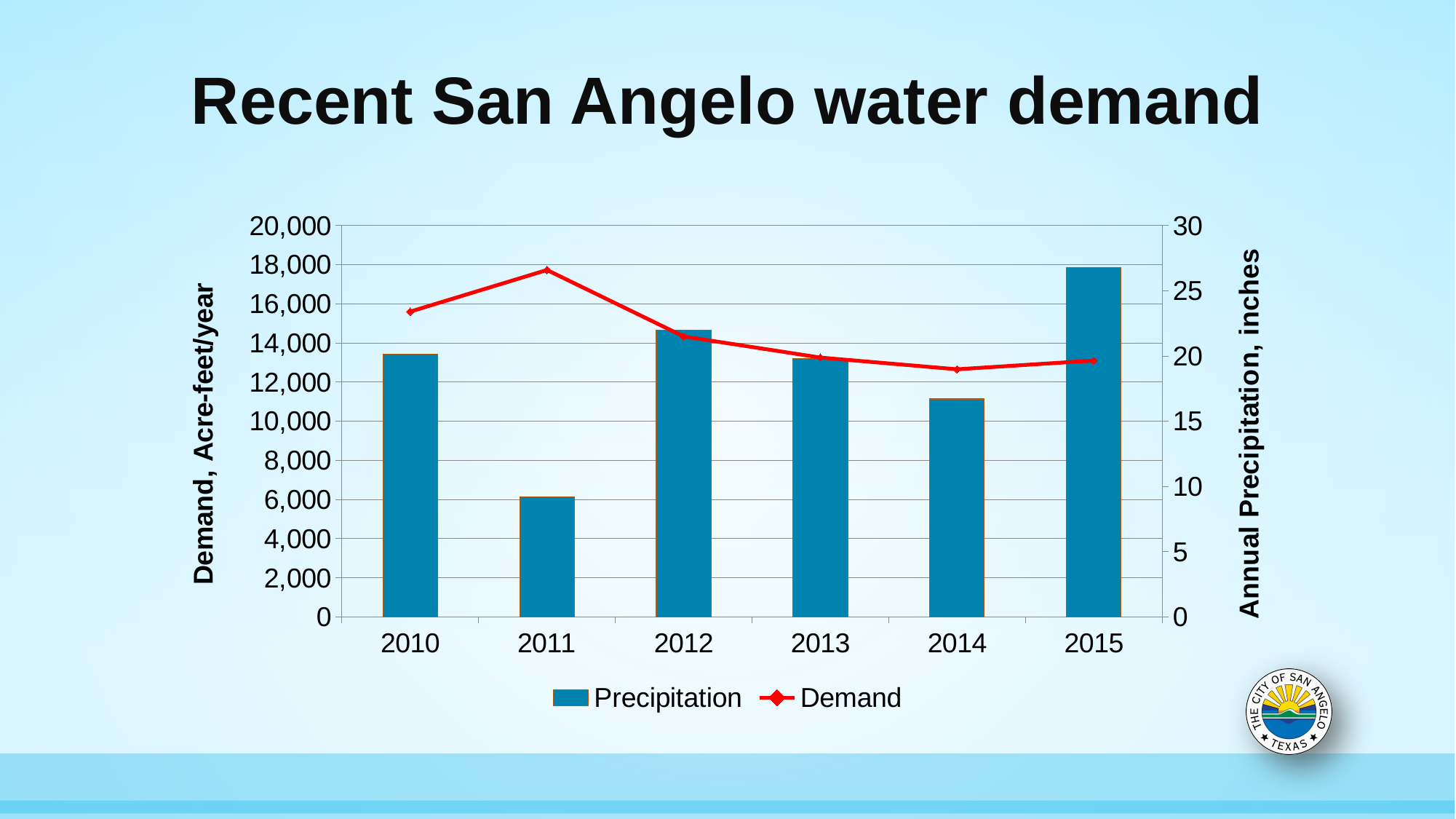
Which year has the shortest bar? 2011 Which year has the tallest bar? 2015 How many series does the legend list? 2 What kind of chart is shown on the slide? A bar chart combined with a line Is the bar for 2011 greater or less than 8,000 on the left axis? less What is the title of the chart? Recent San Angelo water demand Does the red Demand line rise or fall from 2011 to 2014? fall Which bar is taller, 2012 or 2014? 2012 Is the bar for 2015 greater or less than 16,000 on the left axis? greater In which year does the red Demand line reach its highest point? 2011 How many years are shown on the x axis? 6 Is the red Demand line for 2011 greater or less than 25 on the right axis? greater